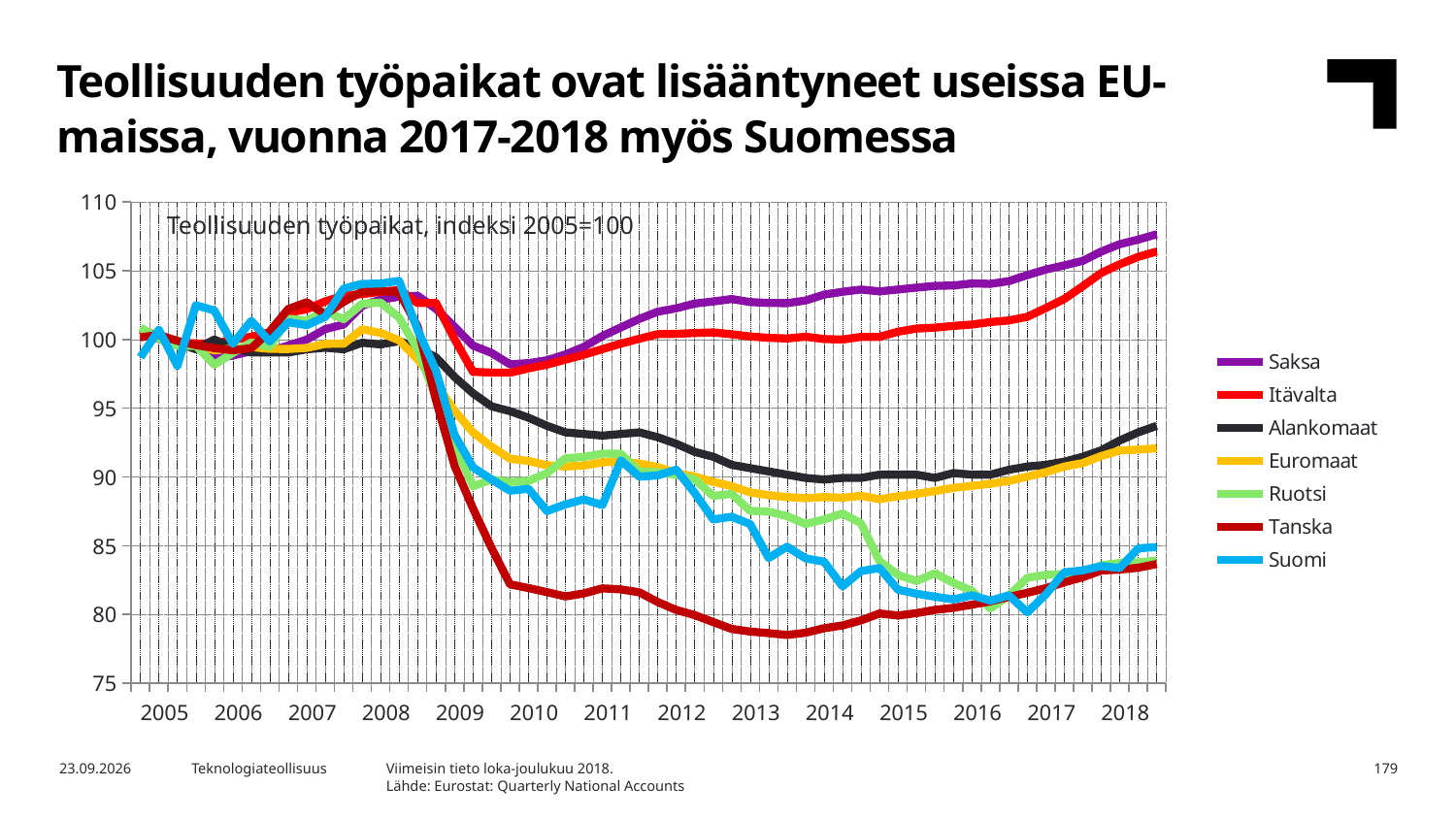
What is the title printed inside the chart area? Teollisuuden työpaikat, indeksi 2005=100 Which countries or regions are listed in the legend? Saksa, Itävalta, Alankomaat, Euromaat, Ruotsi, Tanska, Suomi How many years are labelled on the x axis? 14 Is the value for Saksa at the end of 2018 greater or less than 105? greater Does the Tanska series rise or fall between 2008 and 2013? fall Is the value for Tanska in 2013 greater or less than 80? less At the end of 2018, which is higher: Itävalta or Euromaat? Itävalta How many series does the legend list? 7 Which series has the lowest value in 2013? Tanska Which series has the highest value at the end of 2018? Saksa What kind of chart is shown on the slide? line chart Is the value for Alankomaat at the end of 2018 greater or less than 95? less